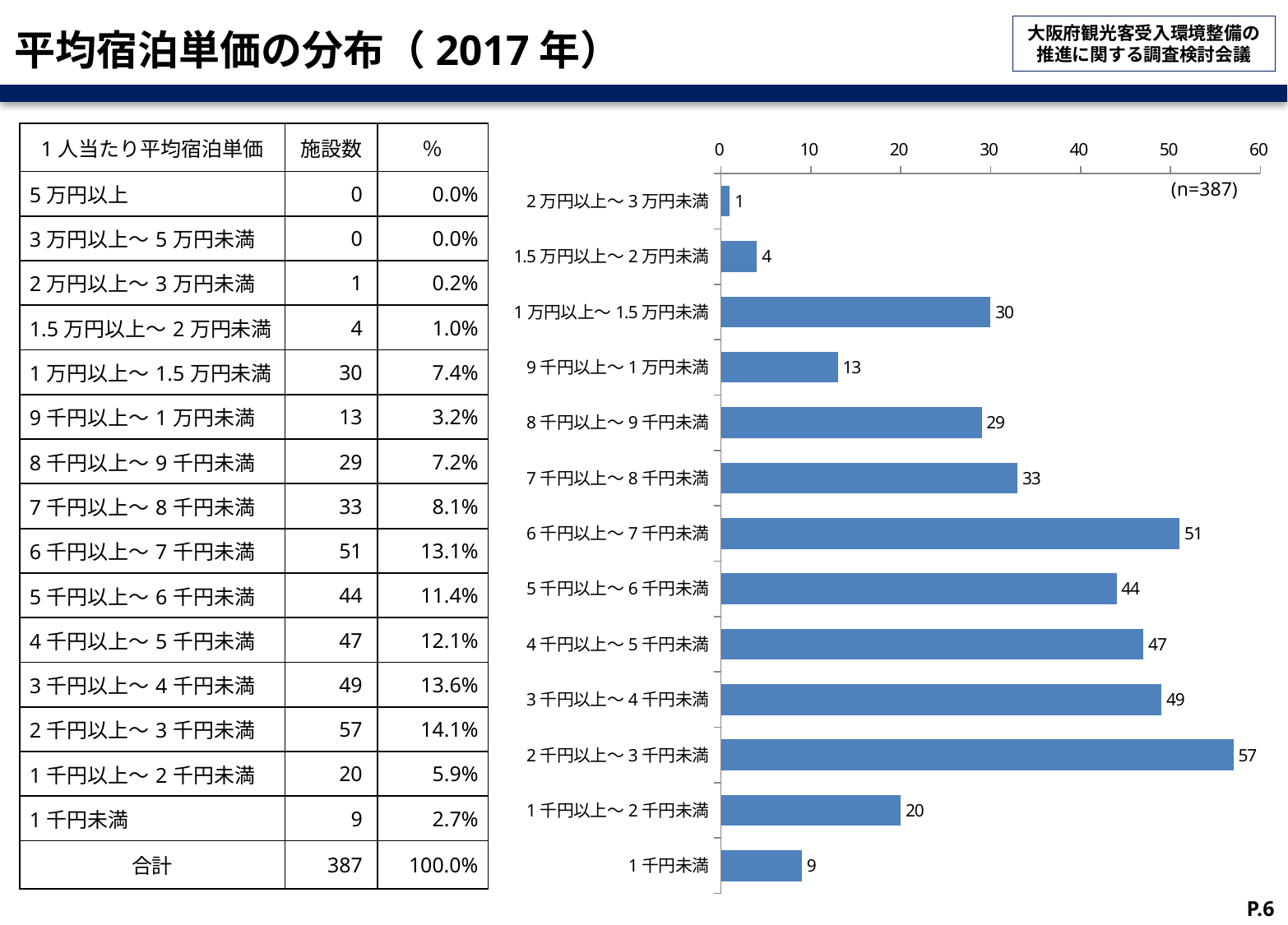
What is the difference between the values for 6千円以上～7千円未満 and 5千円以上～6千円未満? 7 Which is larger: the value for 8千円以上～9千円未満 or the value for 7千円以上～8千円未満? 7千円以上～8千円未満 How many categories (bars) does the chart show? 13 What is the value for 2千円以上～3千円未満 in the chart? 57 What sample size (n) is noted on the chart? n=387 Which category has the highest value in the chart? 2千円以上～3千円未満 What is the value for 1万円以上～1.5万円未満 in the chart? 30 What is the value for 1千円未満 in the chart? 9 Is the value for 4千円以上～5千円未満 greater or less than 40? greater What is the difference between the values for 1千円以上～2千円未満 and 9千円以上～1万円未満? 7 Which category has the lowest value in the chart? 2万円以上～3万円未満 What type of chart is shown on the slide? bar chart